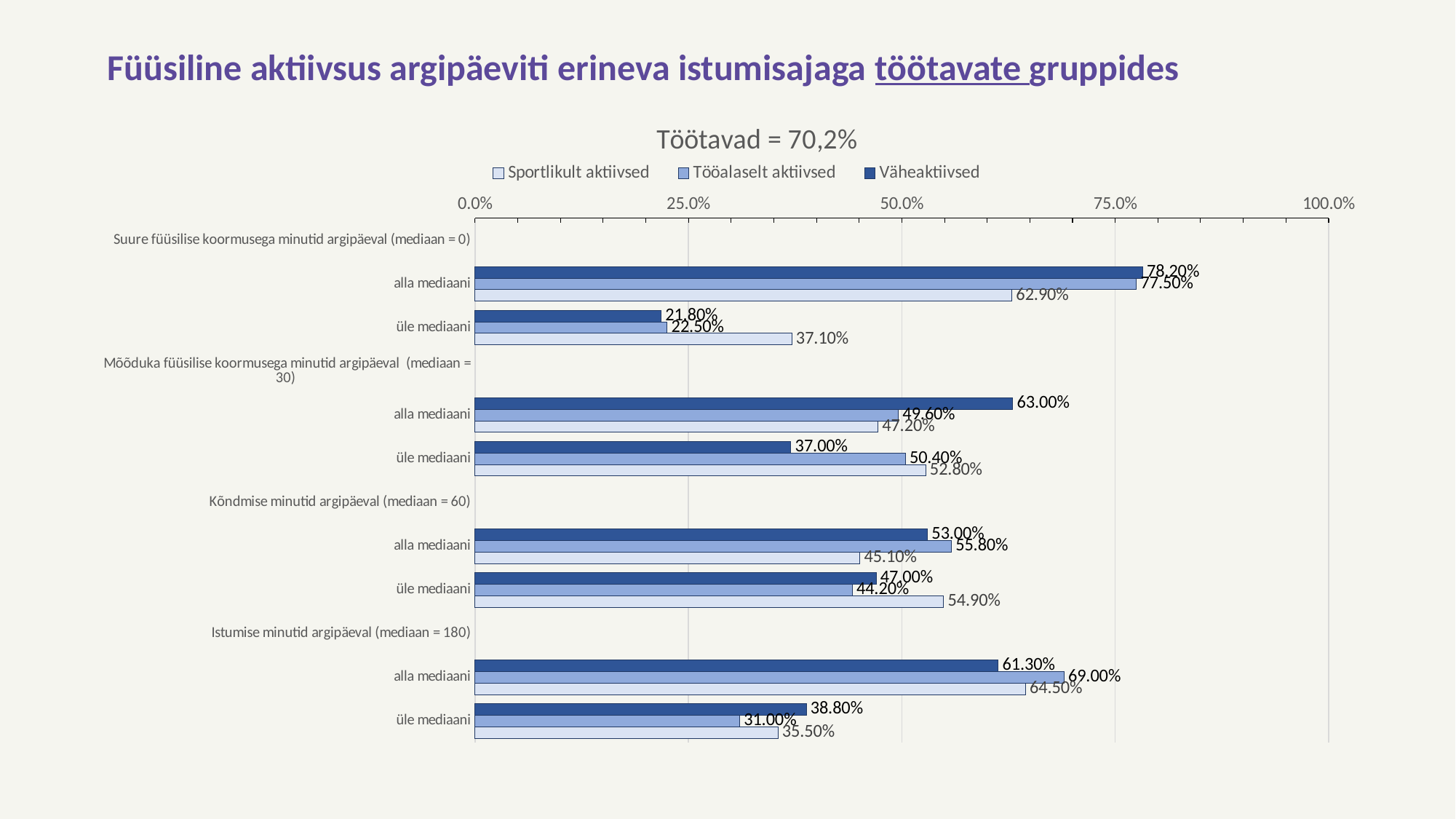
Which series has the lowest value in the 'üle mediaani' row under 'Istumise minutid argipäeval (mediaan = 180)'? Tööalaselt aktiivsed What kind of chart is shown on the slide? bar chart What is the chart title? Töötavad = 70,2% What is the value for Väheaktiivsed in the 'alla mediaani' row under 'Suure füüsilise koormusega minutid argipäeval (mediaan = 0)'? 78.20% What is the value for Tööalaselt aktiivsed in the 'alla mediaani' row under 'Istumise minutid argipäeval (mediaan = 180)'? 69.00% How many series does the legend list? 3 What is the difference between the Väheaktiivsed and Sportlikult aktiivsed values in the 'alla mediaani' row under 'Suure füüsilise koormusega minutid argipäeval (mediaan = 0)'? 15.30% Is the value for Tööalaselt aktiivsed in the 'alla mediaani' row under 'Kõndmise minutid argipäeval (mediaan = 60)' greater or less than 50.0%? greater Which series has the highest value in the 'alla mediaani' row under 'Mõõduka füüsilise koormusega minutid argipäeval (mediaan = 30)'? Väheaktiivsed In the 'üle mediaani' row under 'Kõndmise minutid argipäeval (mediaan = 60)', which is larger: Sportlikult aktiivsed or Väheaktiivsed? Sportlikult aktiivsed What is the value for Väheaktiivsed in the 'üle mediaani' row under 'Mõõduka füüsilise koormusega minutid argipäeval (mediaan = 30)'? 37.00% What is the value for Sportlikult aktiivsed in the 'üle mediaani' row under 'Suure füüsilise koormusega minutid argipäeval (mediaan = 0)'? 37.10%